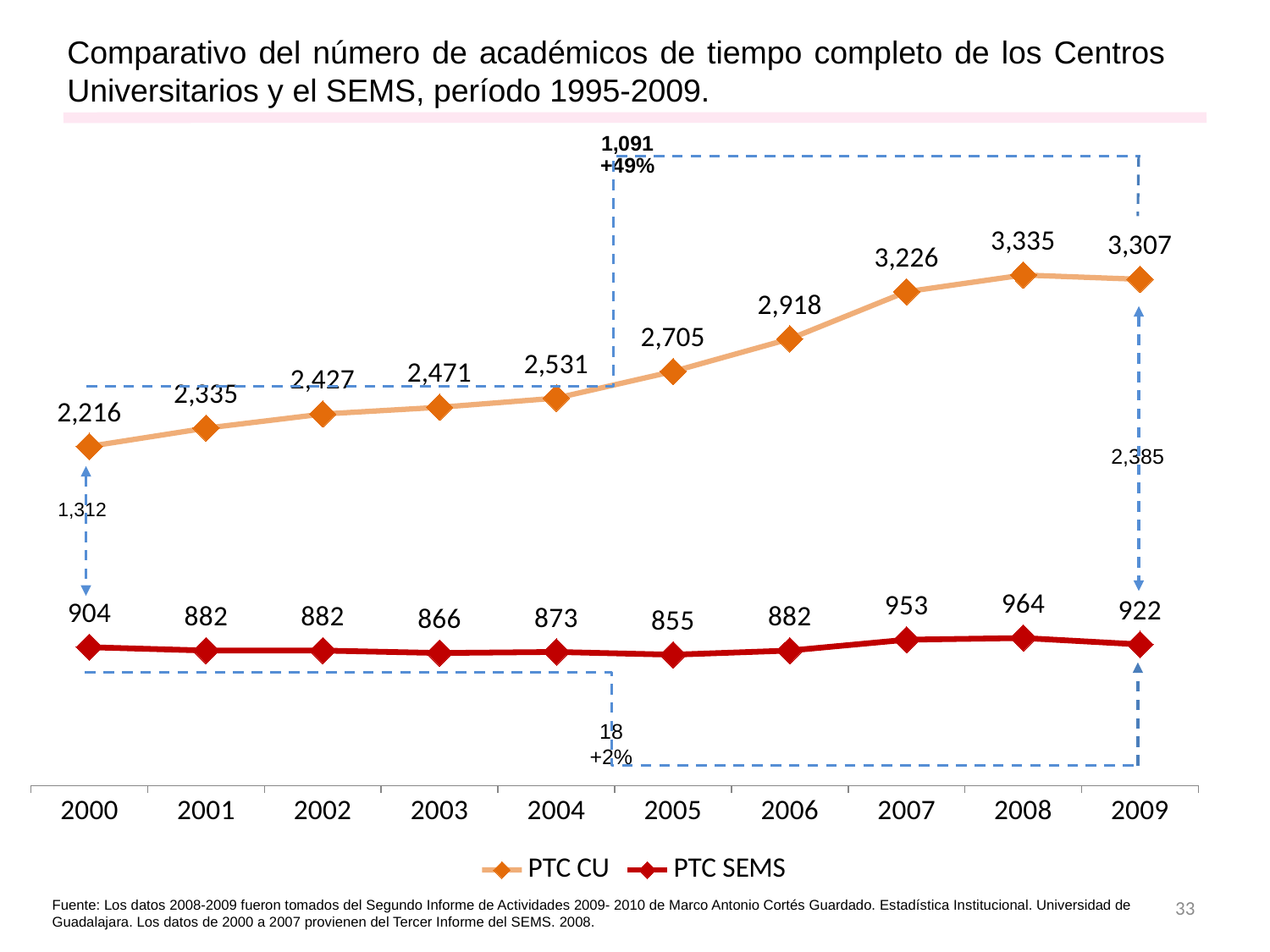
Does PTC CU generally rise or fall from 2000 to 2008? Rise What is the value of PTC SEMS in 2008? 964 How many series does the legend list? 2 In which year is PTC CU highest? 2008 Which is larger, PTC SEMS in 2007 or PTC SEMS in 2009? PTC SEMS in 2007 What is the value of PTC CU in 2000? 2,216 What is the value of PTC CU in 2005? 2,705 What is the difference between PTC CU in 2008 and PTC CU in 2007? 109 How many years are shown on the x axis? 10 What is the difference between PTC CU and PTC SEMS in 2009? 2,385 What kind of chart is shown? Line chart In which year is PTC SEMS lowest? 2005